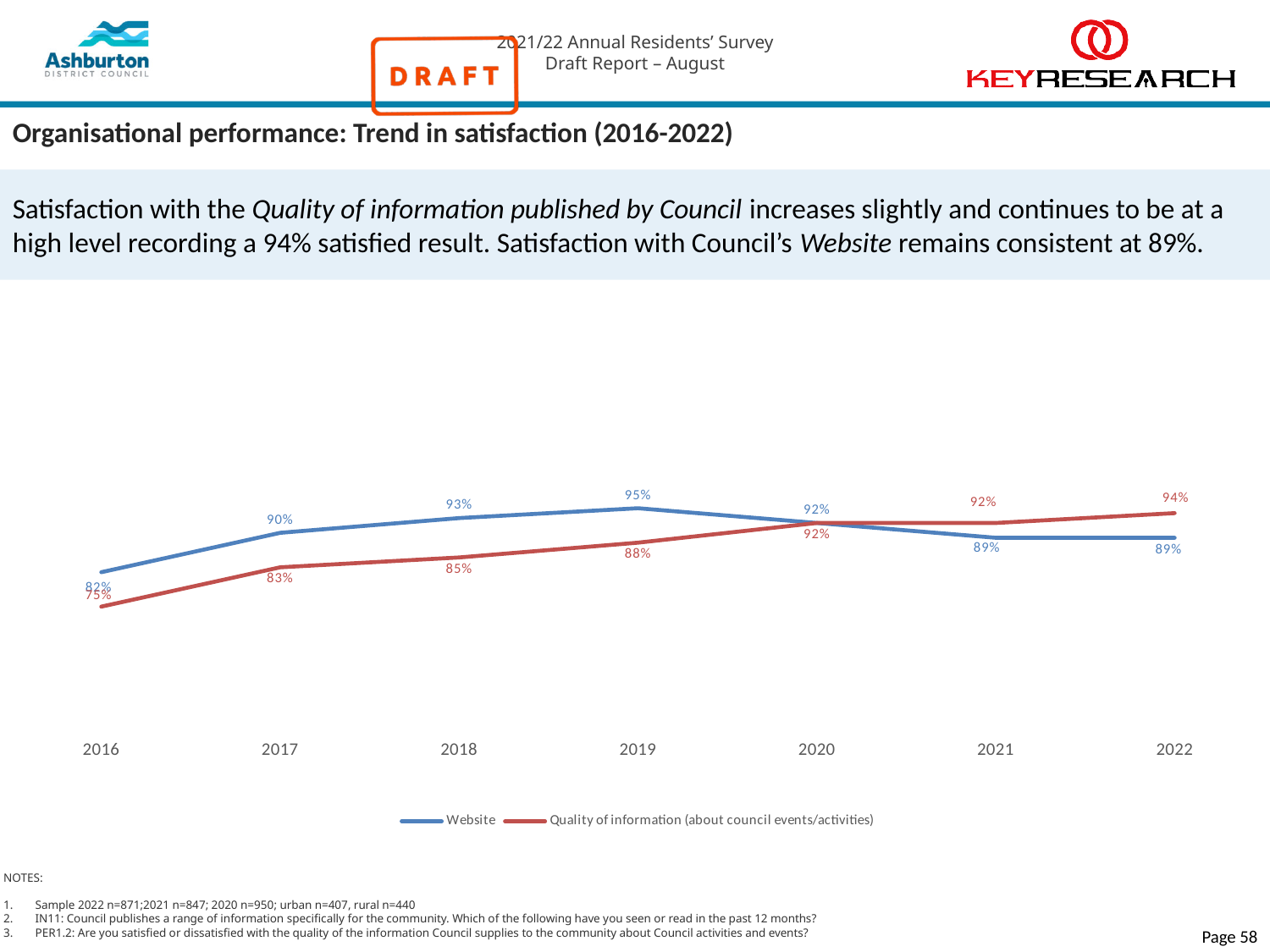
What type of chart is shown on the slide? Line chart What was the satisfaction value for Website in 2019? 95% What was the satisfaction value for Quality of information (about council events/activities) in 2018? 85% How many years are shown on the x axis? 7 Does the Quality of information series rise or fall from 2016 to 2022? Rises In which year did the Website series reach its highest value? 2019 How many series does the legend list? 2 In 2022, which series has the higher value: Website or Quality of information? Quality of information In which year was the Quality of information series at its lowest value? 2016 What is the difference between the Website value in 2019 and the Website value in 2022? 6 percentage points What was the satisfaction value for Website in 2022? 89% What was the satisfaction value for Quality of information (about council events/activities) in 2022? 94%